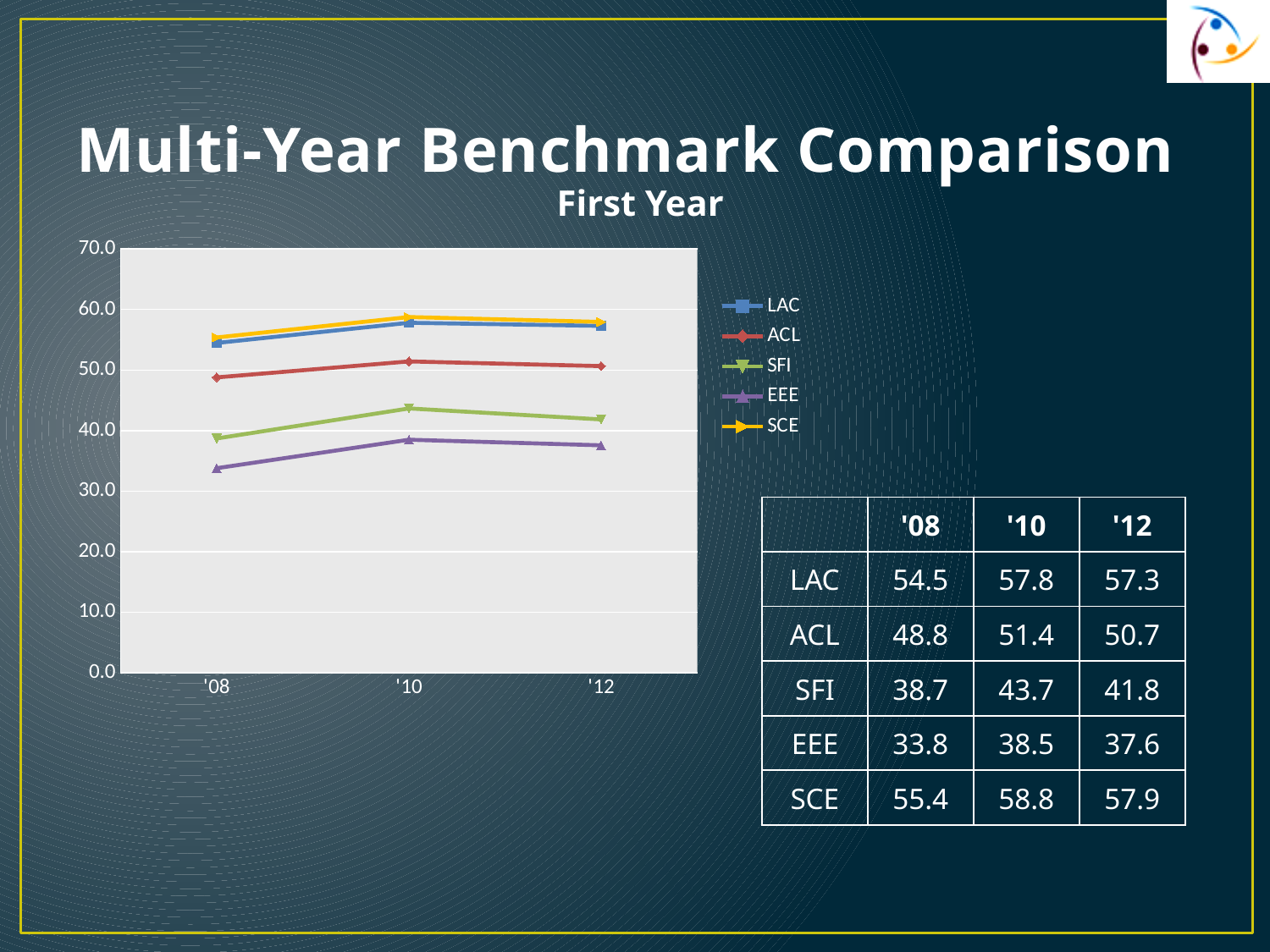
What is the value for LAC in '10? 57.8 How many series does the chart's legend list? 5 Which is larger, the ACL value in '12 or the SFI value in '12? ACL Is the value for EEE in '10 greater or less than 40.0? less Which series has the lowest value in '12? EEE Does the LAC line rise or fall from '08 to '10? rise Which series has the highest value in '10? SCE What is the value for EEE in '08? 33.8 What kind of chart is shown on the slide? line chart What is the difference between the SFI values in '10 and '08? 5.0 How many years are plotted along the x axis of the chart? 3 What is the value for SCE in '12? 57.9